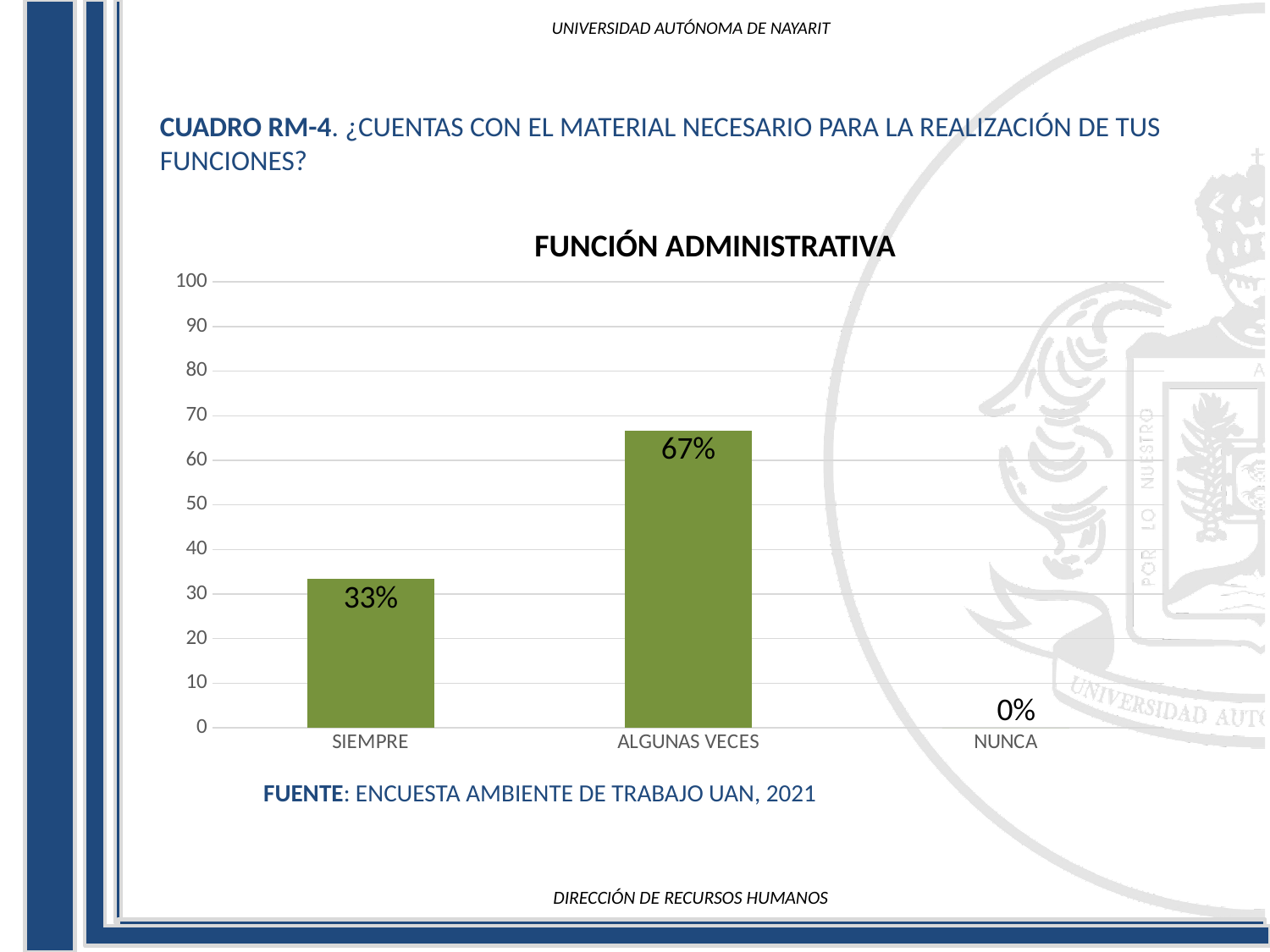
How many categories are shown on the x axis? 3 Which category has the highest value? ALGUNAS VECES Which is larger, the value for SIEMPRE or the value for ALGUNAS VECES? ALGUNAS VECES What is the value for ALGUNAS VECES? 67% What is the title of the chart? FUNCIÓN ADMINISTRATIVA What is the value for SIEMPRE? 33% What kind of chart is shown on the slide? bar chart Is the value for ALGUNAS VECES greater or less than 50? greater Is the value for SIEMPRE greater or less than 40? less What is the value for NUNCA? 0% Which category has the lowest value? NUNCA What is the difference between the values for ALGUNAS VECES and SIEMPRE? 34%